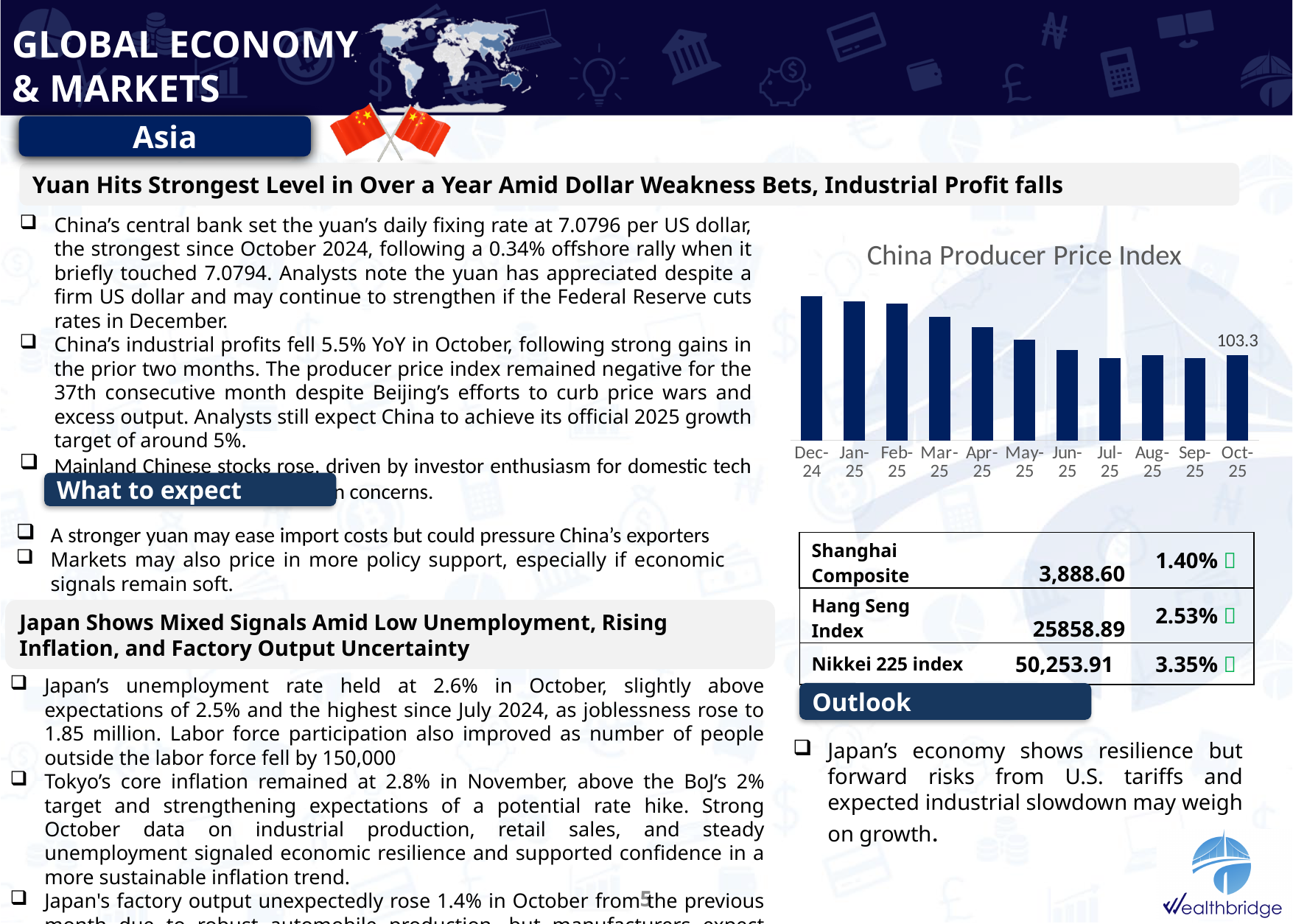
In the China Producer Price Index chart, which is larger, the value for Feb-25 or the value for Jun-25? Feb-25 In the China Producer Price Index chart, do the values generally rise or fall from Dec-24 to Oct-25? fall What is the value of the China Producer Price Index for Oct-25? 103.3 What kind of chart is the China Producer Price Index chart? bar chart What is the title of the chart on the slide? China Producer Price Index In the China Producer Price Index chart, which is larger, the value for Mar-25 or the value for May-25? Mar-25 In the China Producer Price Index chart, which is larger, the value for Dec-24 or the value for Oct-25? Dec-24 Which month has the highest value in the China Producer Price Index chart? Dec-24 What is the first month shown on the x axis of the China Producer Price Index chart? Dec-24 Which month is the only one with a data label printed in the China Producer Price Index chart? Oct-25 How many months are plotted in the China Producer Price Index chart? 11